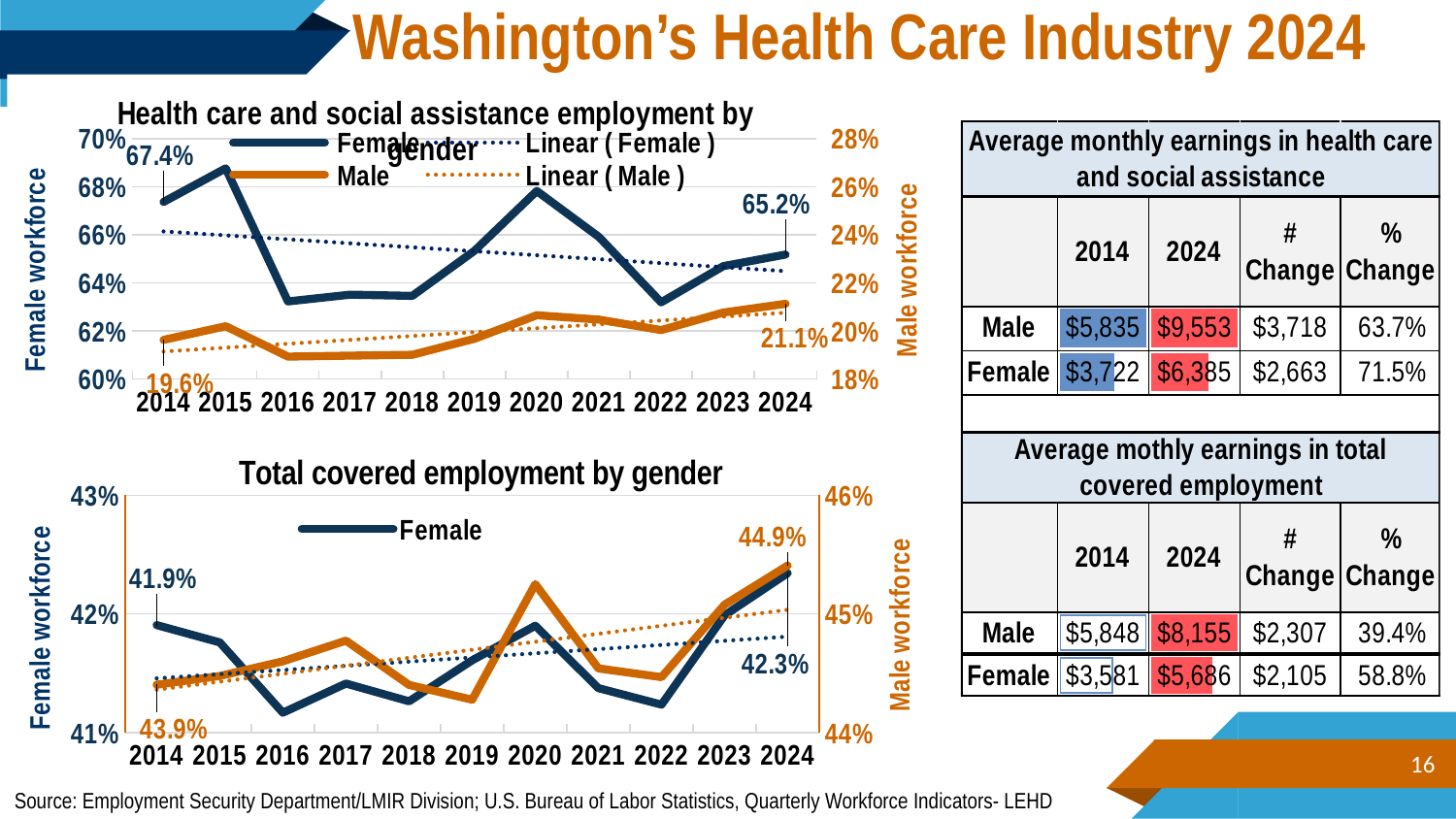
In the top chart, 'Health care and social assistance employment by gender', what is the Female workforce share in 2014? 67.4% How many years are plotted along the x axis of the bottom chart, 'Total covered employment by gender'? 11 In the top chart, 'Health care and social assistance employment by gender', what is the Female workforce share in 2024? 65.2% In the top chart, 'Health care and social assistance employment by gender', what is the Male workforce share in 2024? 21.1% In the bottom chart, 'Total covered employment by gender', is the Female value for 2016 greater or less than 42%? less In the bottom chart, 'Total covered employment by gender', what is the Male workforce share in 2024? 44.9% In the top chart, 'Health care and social assistance employment by gender', does the Male share generally rise or fall from 2014 to 2024? rise In the top chart, 'Health care and social assistance employment by gender', is the Female value for 2016 greater or less than 64%? less In the bottom chart, 'Total covered employment by gender', by how many percentage points did the Male share increase from 2014 (43.9%) to 2024? 1.0 percentage point How many entries does the legend of the top chart, 'Health care and social assistance employment by gender', list? 4 What kind of chart is the top chart, 'Health care and social assistance employment by gender'? line chart In the top chart, 'Health care and social assistance employment by gender', by how many percentage points did the Female share fall from 2014 to 2024? 2.2 percentage points